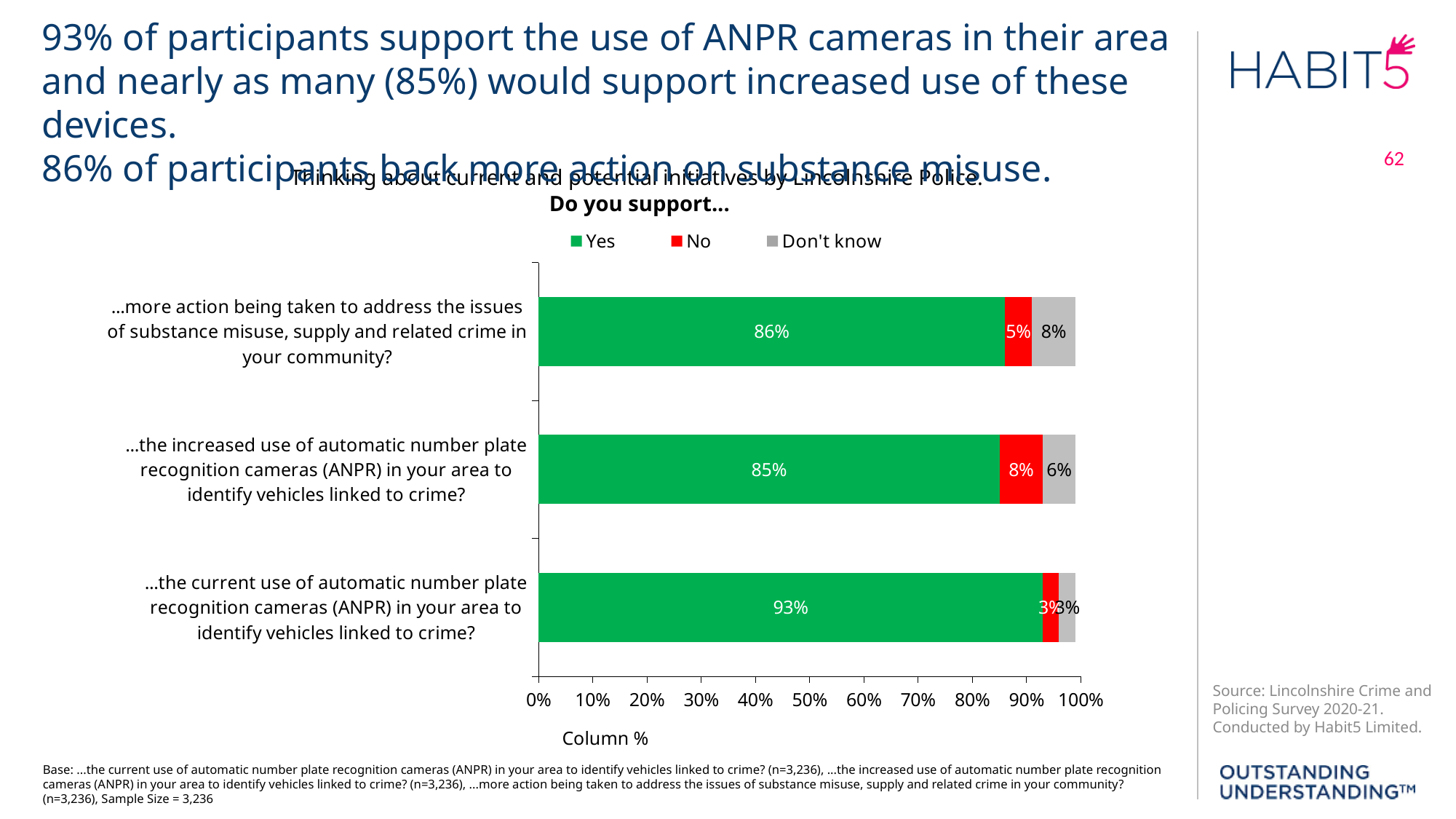
What percentage of participants said No to the increased use of ANPR cameras in their area? 8% Which initiative has the lowest No percentage? ...the current use of automatic number plate recognition cameras (ANPR) in your area to identify vehicles linked to crime? Which initiative has the highest Yes percentage? ...the current use of automatic number plate recognition cameras (ANPR) in your area to identify vehicles linked to crime? What is the difference in Yes percentage between the current use of ANPR cameras and the increased use of ANPR cameras? 8% How many series does the legend list? 3 What kind of chart is shown on the slide? Stacked bar chart How many initiatives are shown on the chart? 3 What is the combined percentage of No and Don't know responses for the increased use of ANPR cameras? 14% What percentage of participants said Yes to more action being taken to address the issues of substance misuse, supply and related crime in their community? 86% Which colour represents the Yes responses in the chart? Green What percentage of participants answered Don't know for the current use of ANPR cameras in their area? 3% Is the Don't know percentage larger for more action on substance misuse or for the increased use of ANPR cameras? More action on substance misuse